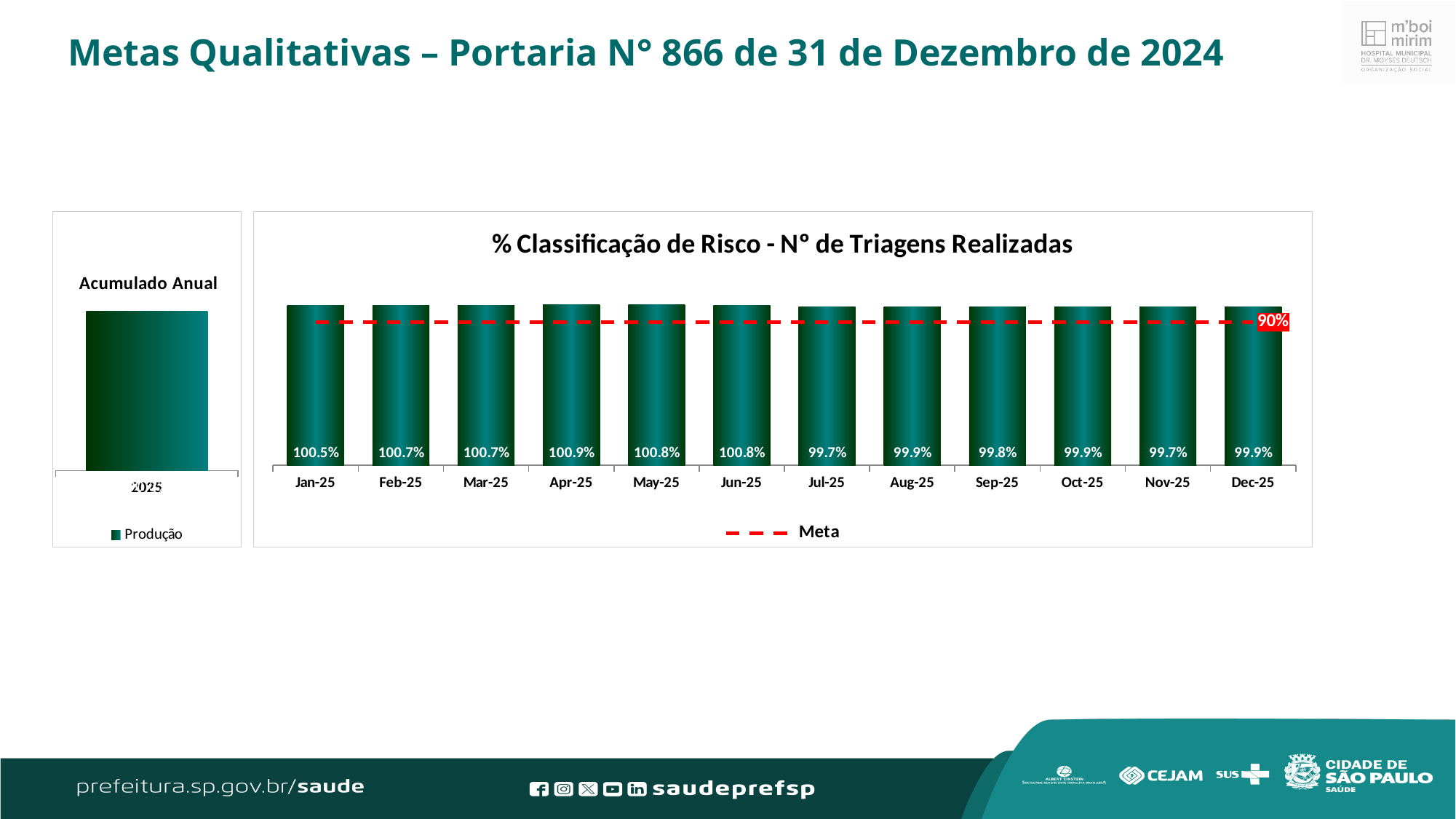
In the chart titled '% Classificação de Risco - N° de Triagens Realizadas', how many months are plotted? 12 In the chart titled 'Acumulado Anual' on the left, how many bars are plotted? 1 In the chart titled '% Classificação de Risco - N° de Triagens Realizadas', what is the value for Jan-25? 100.5% In the chart titled '% Classificação de Risco - N° de Triagens Realizadas', which is larger, the value for Feb-25 or the value for Aug-25? Feb-25 In the chart titled '% Classificação de Risco - N° de Triagens Realizadas', what is the value for Apr-25? 100.9% In the chart titled 'Acumulado Anual' on the left, what is the legend entry? Produção In the chart titled '% Classificação de Risco - N° de Triagens Realizadas', which month has the highest value? Apr-25 In the chart titled '% Classificação de Risco - N° de Triagens Realizadas', what is the difference between the values for Apr-25 and Jul-25? 1.2 percentage points In the chart titled '% Classificação de Risco - N° de Triagens Realizadas', what target value does the dashed 'Meta' line mark? 90% In the chart titled '% Classificação de Risco - N° de Triagens Realizadas', what is the value for Dec-25? 99.9% In the chart titled '% Classificação de Risco - N° de Triagens Realizadas', what is the value for Sep-25? 99.8% What kind of chart is the chart titled '% Classificação de Risco - N° de Triagens Realizadas'? Combination bar and line chart (bars with a dashed 'Meta' target line)